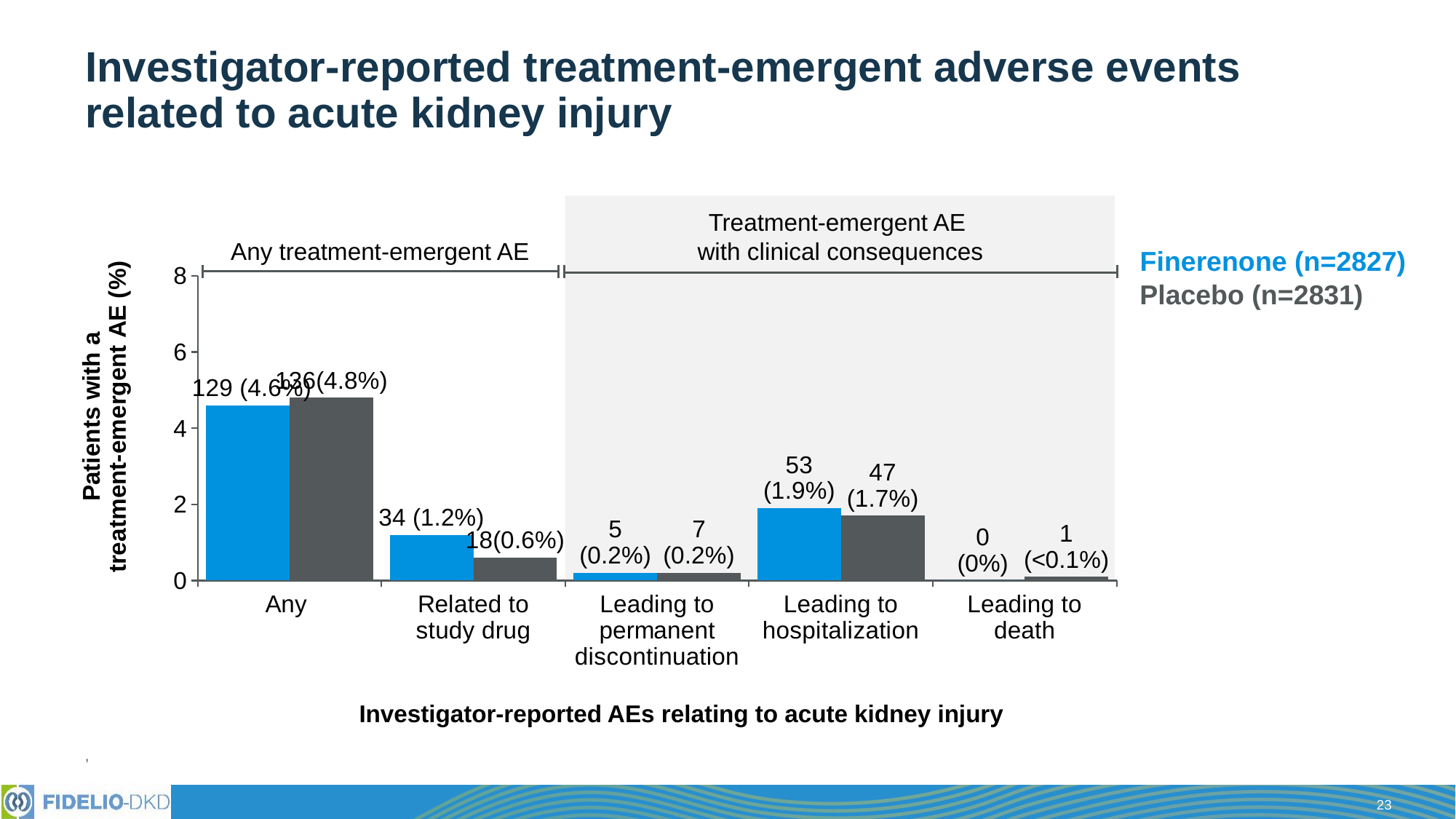
What is the difference in patient counts between Finerenone and Placebo in the 'Leading to hospitalization' category? 6 Which category has the lowest value for Placebo? Leading to death What kind of chart is shown on the slide? bar chart Which category has the highest value for Finerenone? Any Is the Placebo value for 'Any' greater or less than 4%? greater What is the data label for Placebo in the 'Related to study drug' category? 18(0.6%) How many categories are shown on the x axis? 5 What is the data label for Finerenone in the 'Leading to hospitalization' category? 53 (1.9%) How many series does the chart show? 2 In the 'Related to study drug' category, which series has the larger value, Finerenone or Placebo? Finerenone What is the data label for Placebo in the 'Leading to death' category? 1 (<0.1%) What is the data label for Finerenone in the 'Leading to permanent discontinuation' category? 5 (0.2%)